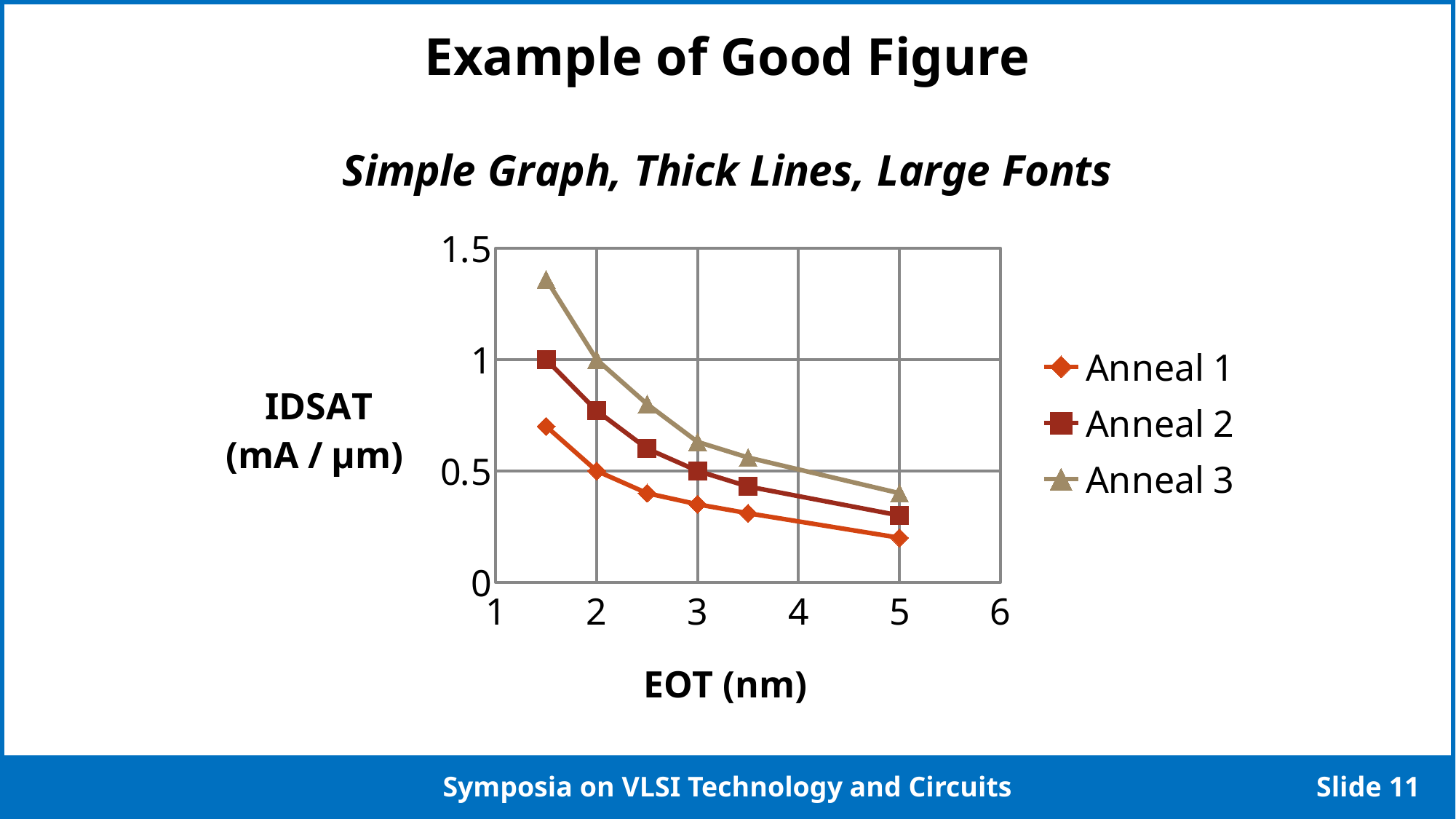
What kind of chart is shown on the slide? line chart How many series does the legend list? 3 What is the IDSAT value for Anneal 3 at EOT 2 nm? 1 Is the IDSAT value for Anneal 1 at EOT 5 nm greater or less than 0.5? less Is the IDSAT value for Anneal 3 at EOT 1.5 nm greater or less than 1? greater Which series has the lowest IDSAT value at EOT 5 nm? Anneal 1 What is the IDSAT value for Anneal 1 at EOT 2 nm? 0.5 What is the IDSAT value for Anneal 2 at EOT 1.5 nm? 1 Which series has the highest IDSAT value at EOT 1.5 nm? Anneal 3 How many data points are plotted for the Anneal 1 series? 6 What is the IDSAT value for Anneal 2 at EOT 3 nm? 0.5 Do the IDSAT values rise or fall as EOT increases? fall